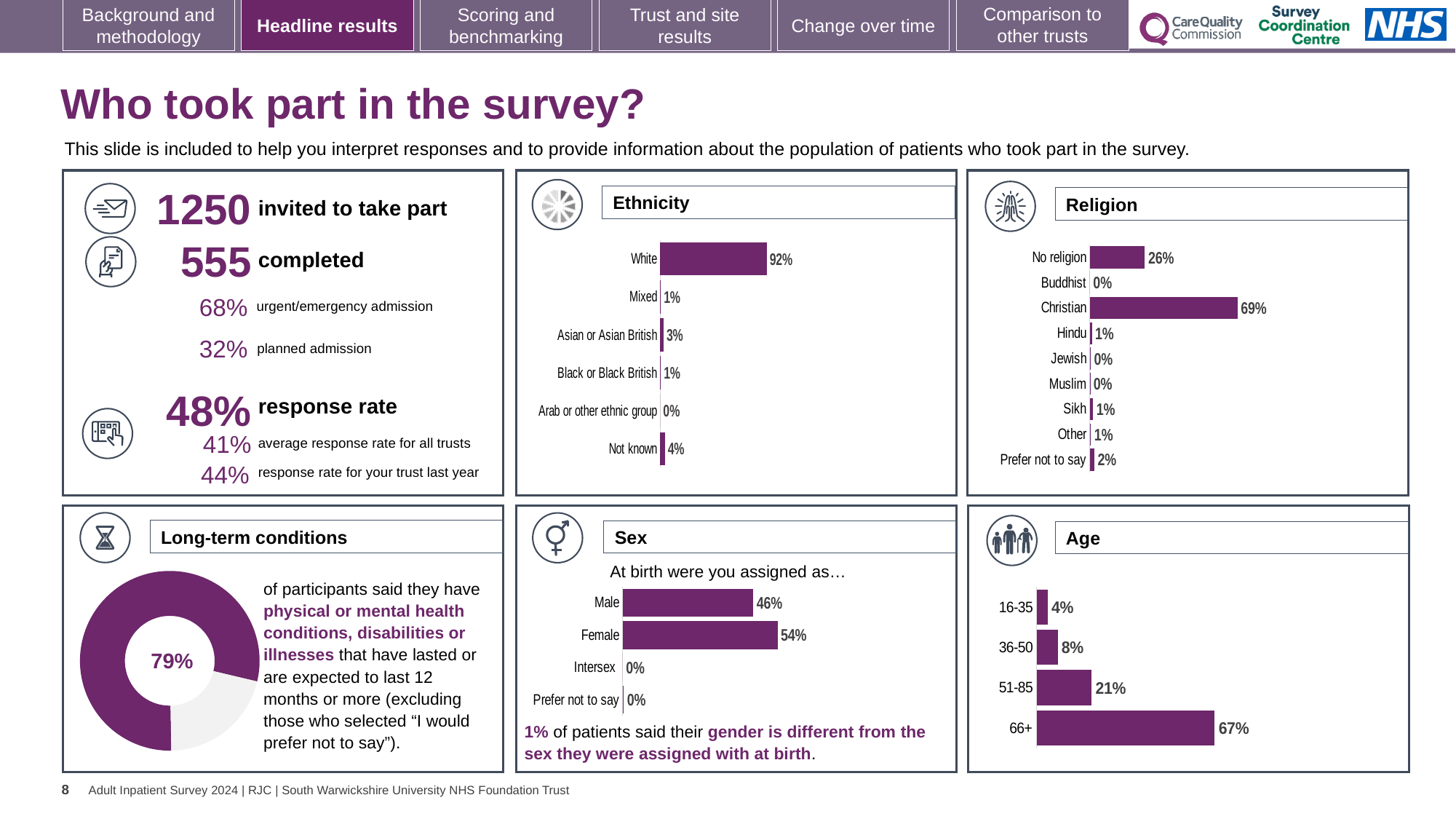
In the Sex chart, what percentage of respondents were assigned Female at birth? 54% In the Age chart, do the values rise or fall as age increases? rise In the Age chart, what percentage of respondents are aged 66+? 67% In the Ethnicity chart, how many categories are shown? 6 What kind of chart is the Long-term conditions chart? doughnut chart In the Ethnicity chart, what percentage of respondents are White? 92% In the Religion chart, how many categories are shown? 9 In the Religion chart, what percentage of respondents are Christian? 69% In the Ethnicity chart, which category has the highest value? White In the Religion chart, what is the difference between Christian and No religion? 43% In the Sex chart, which is larger, Male or Female? Female In the Age chart, which age group has the lowest value? 16-35